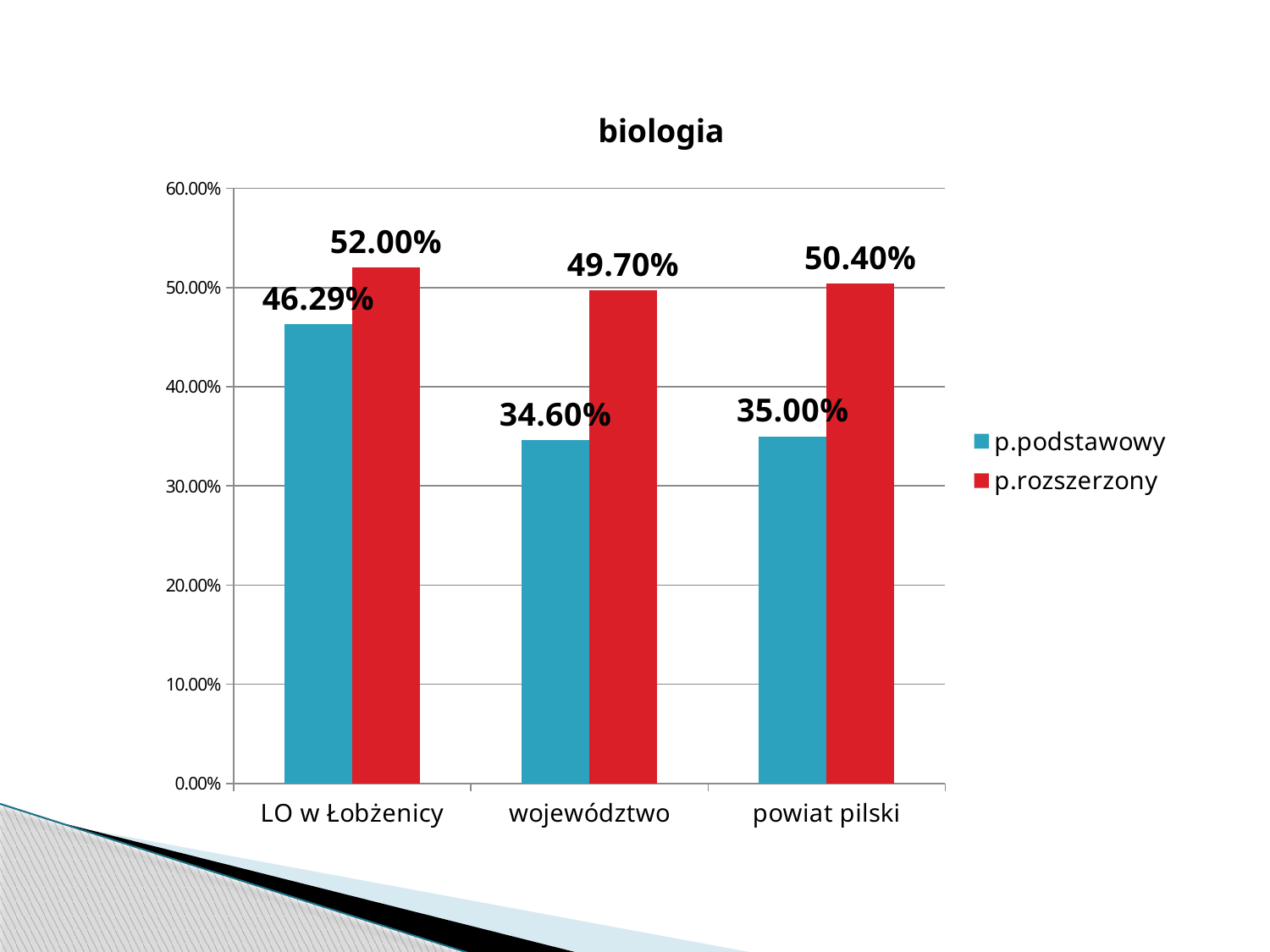
How many categories are shown on the x axis? 3 Which category has the highest p.rozszerzony value? LO w Łobżenicy Which category has the lowest p.podstawowy value? województwo Is the p.podstawowy value for województwo greater or less than 40.00%? less What is the value for p.rozszerzony for województwo? 49.70% How many series does the legend list? 2 What kind of chart is shown on the slide? bar chart What is the difference between the p.rozszerzony values for powiat pilski and województwo? 0.70% What is the value for p.podstawowy for powiat pilski? 35.00% Which is larger: the p.podstawowy value for LO w Łobżenicy or for powiat pilski? LO w Łobżenicy What is the difference between the p.rozszerzony and p.podstawowy values for LO w Łobżenicy? 5.71% What is the value for p.podstawowy for LO w Łobżenicy? 46.29%